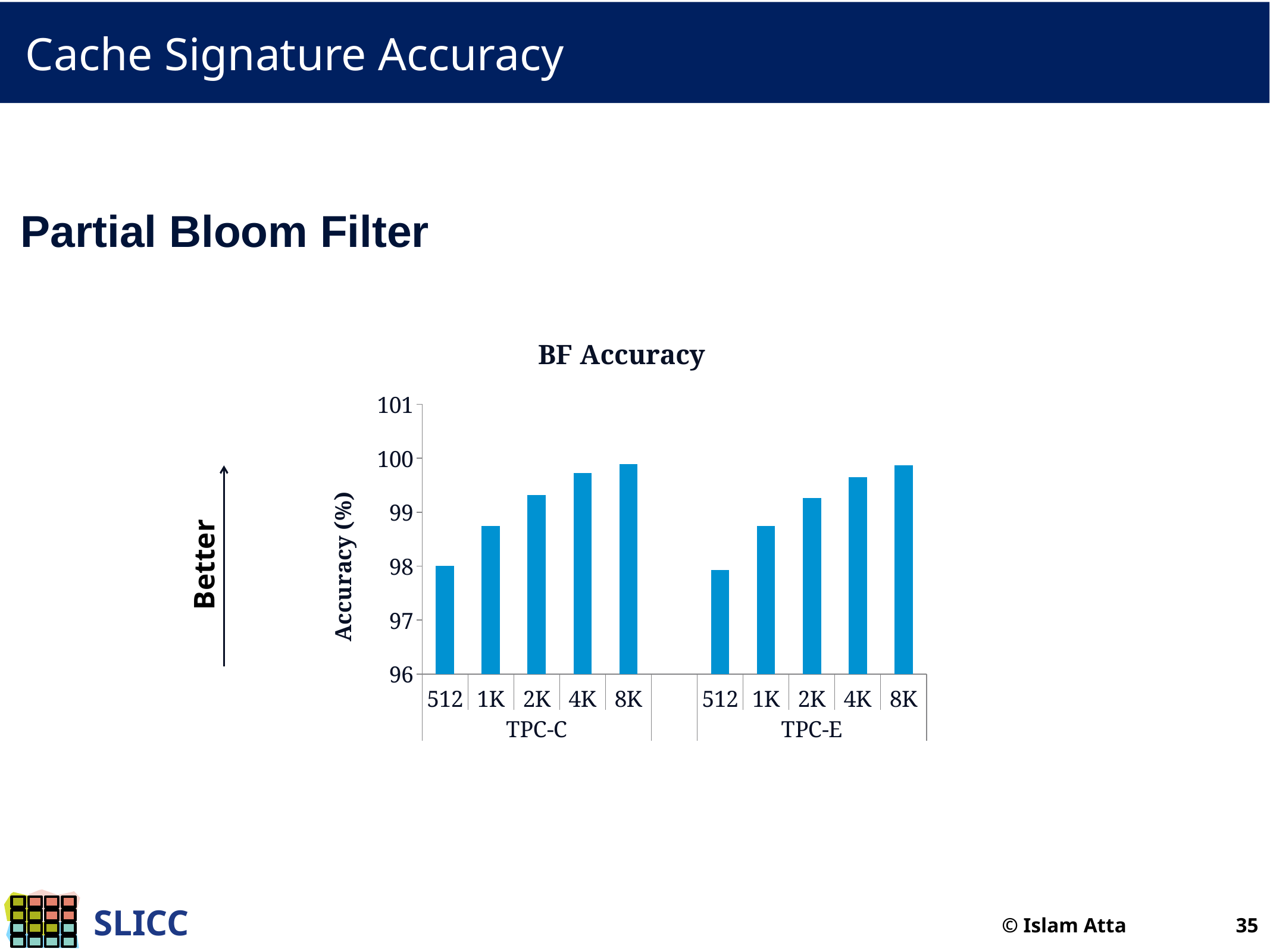
What is the title of the chart? BF Accuracy What kind of chart is shown on the slide? bar chart Is the accuracy for 8K under TPC-C greater or less than 99? greater What is the label of the vertical axis? Accuracy (%) Is the accuracy for 4K under TPC-E greater or less than 100? less Within the TPC-C group, which signature size has the highest accuracy? 8K How many workload groups are shown on the x axis? 2 Within the TPC-E group, does accuracy rise or fall as the signature size increases from 512 to 8K? rise How many bars are plotted in the chart? 10 Within the TPC-E group, which signature size has the lowest accuracy? 512 Which is larger: the accuracy for 512 under TPC-C or for 8K under TPC-C? 8K under TPC-C Is the accuracy for 1K under TPC-C greater or less than 98? greater